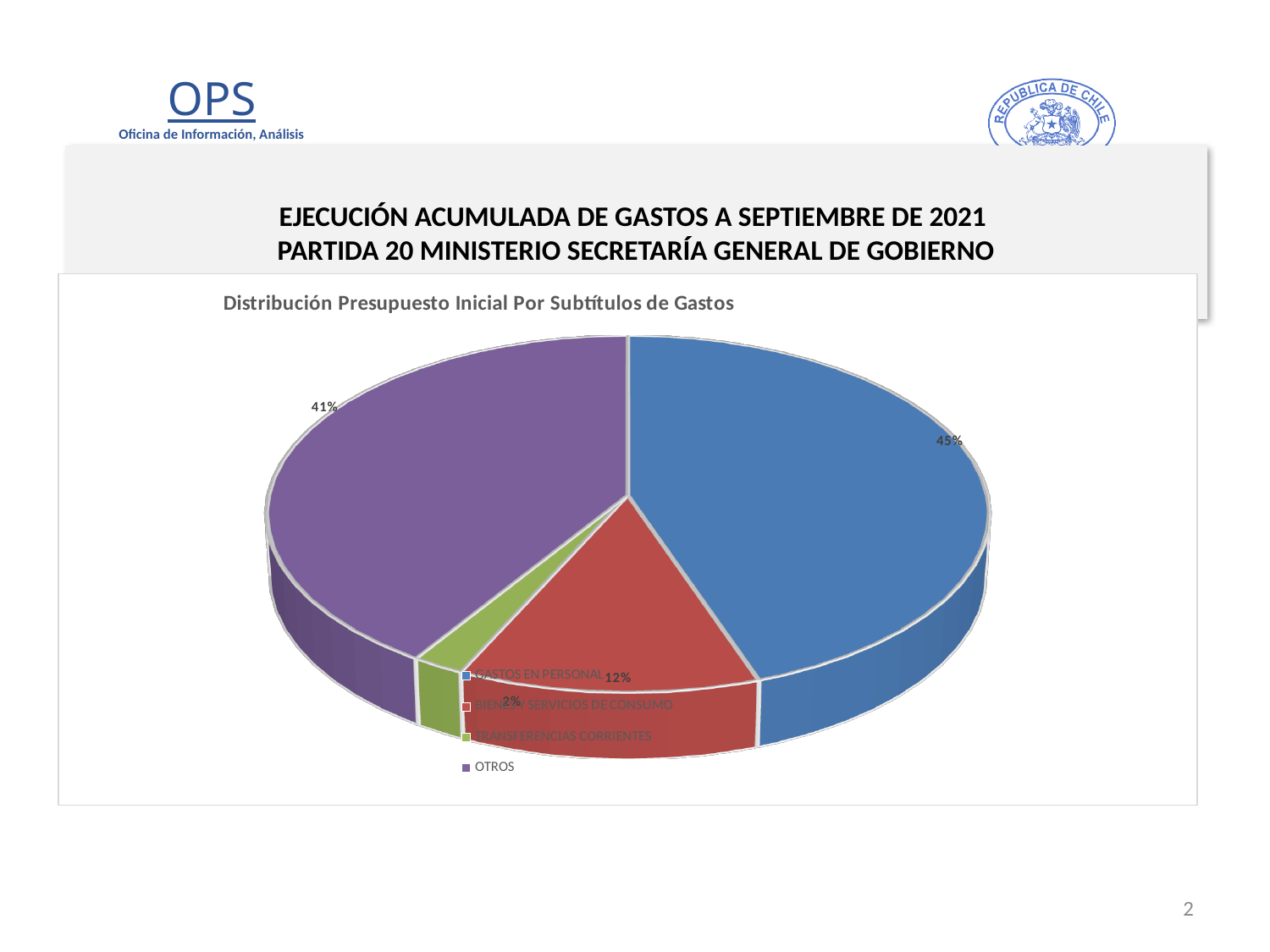
Which category has the smallest slice of the pie? TRANSFERENCIAS CORRIENTES What share of the pie does BIENES Y SERVICIOS DE CONSUMO represent? 12% What colour is the slice for OTROS? Purple What is the difference in percentage points between GASTOS EN PERSONAL and OTROS? 4 percentage points What share of the pie does TRANSFERENCIAS CORRIENTES represent? 2% What is the title of the chart? Distribución Presupuesto Inicial Por Subtítulos de Gastos How many categories does the pie chart show? 4 What kind of chart is shown on the slide? Pie chart What share of the pie does GASTOS EN PERSONAL represent? 45% Which category has the largest slice of the pie? GASTOS EN PERSONAL Which is larger, the share for BIENES Y SERVICIOS DE CONSUMO or the share for TRANSFERENCIAS CORRIENTES? BIENES Y SERVICIOS DE CONSUMO